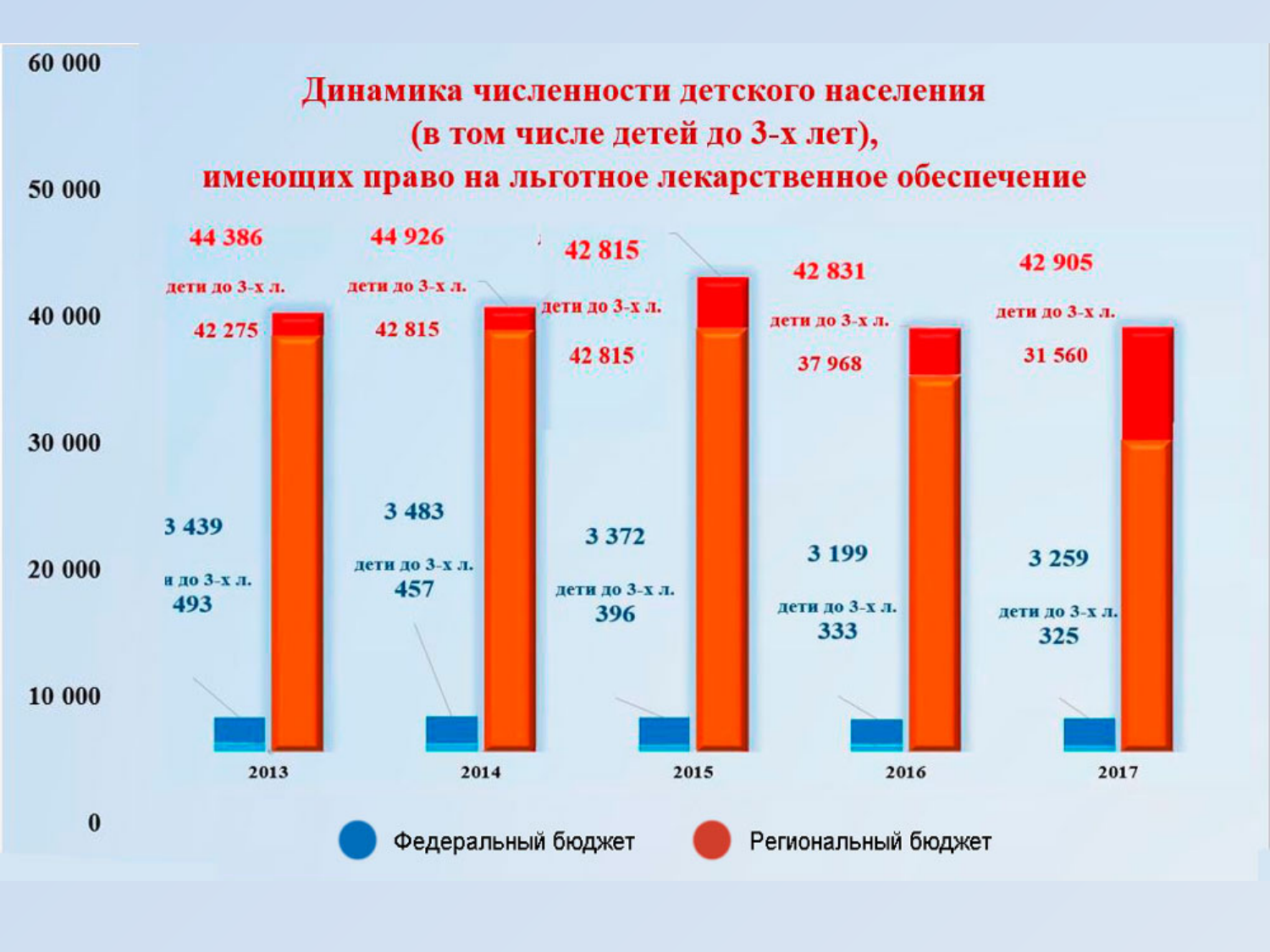
Which is larger: the federal budget value for 2014 or for 2017? 2014 What is the 'дети до 3-х л.' value for the regional budget in 2017? 31 560 How many years are shown on the x axis of the chart? 5 What is the value labelled for the regional budget (Региональный бюджет) in 2014? 44 926 What is the 'дети до 3-х л.' value for the federal budget in 2013? 493 Which series is shown in blue according to the legend? Федеральный бюджет What type of chart is shown on the slide? bar chart How many series does the legend list? 2 Which year has the lowest labelled federal budget value? 2016 Which year has the highest labelled regional budget value? 2014 What is the value labelled for the federal budget (Федеральный бюджет) in 2016? 3 199 What is the difference between the regional budget values for 2014 and 2013? 540